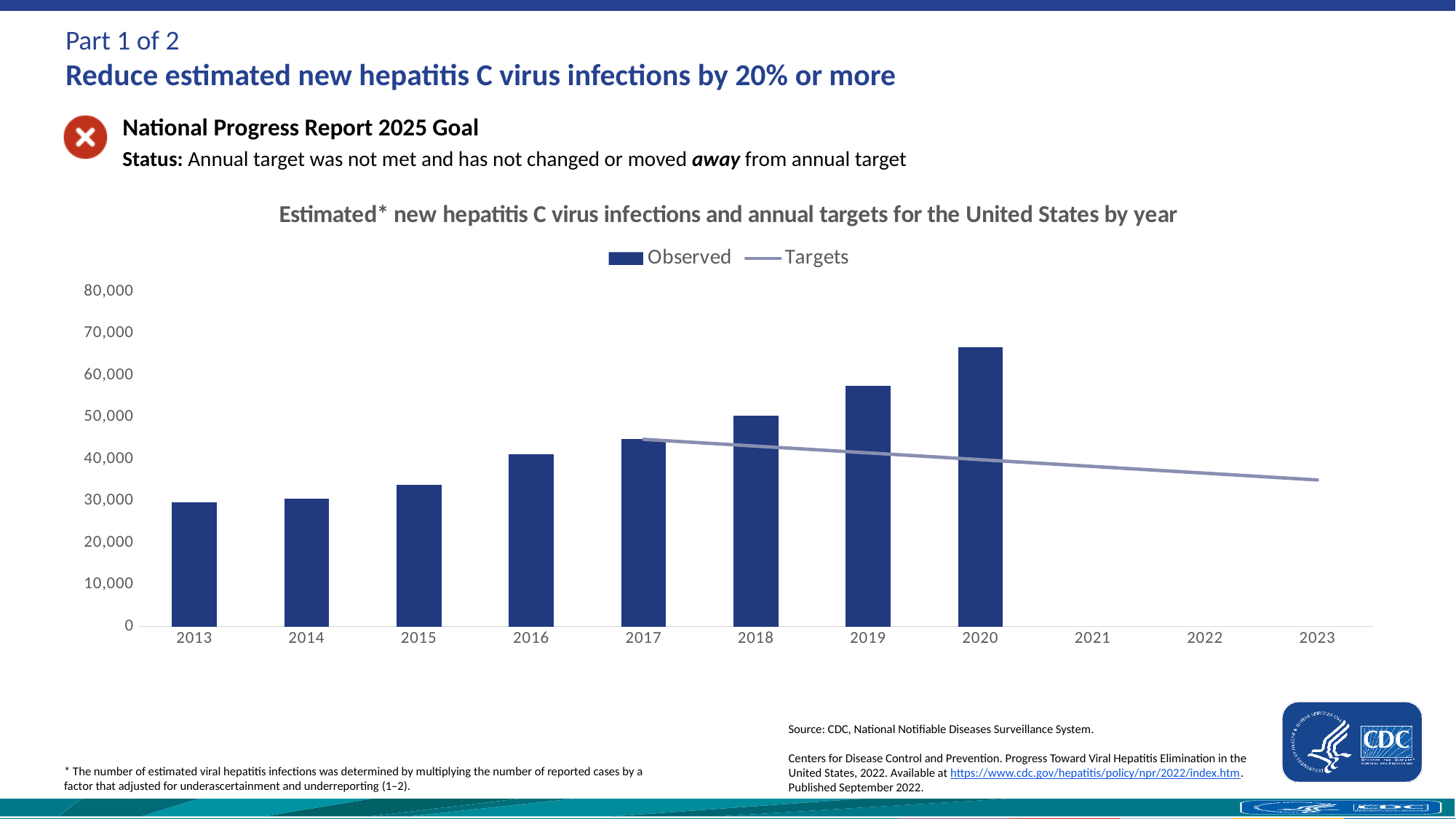
What are the two entries in the chart legend? Observed and Targets Is the Observed value for 2017 greater or less than 50,000? less Does the Targets line rise or fall from 2017 to 2023? fall What kind of chart is used to show the Observed values? bar chart How many series does the legend list? 2 Is the Observed value for 2020 greater or less than 60,000? greater How many years have an Observed bar plotted? 8 Is the Observed value for 2014 greater or less than 40,000? less Which is larger, the Observed value for 2019 or for 2017? 2019 Do the Observed values rise or fall from 2013 to 2020? rise Which year has the highest Observed value? 2020